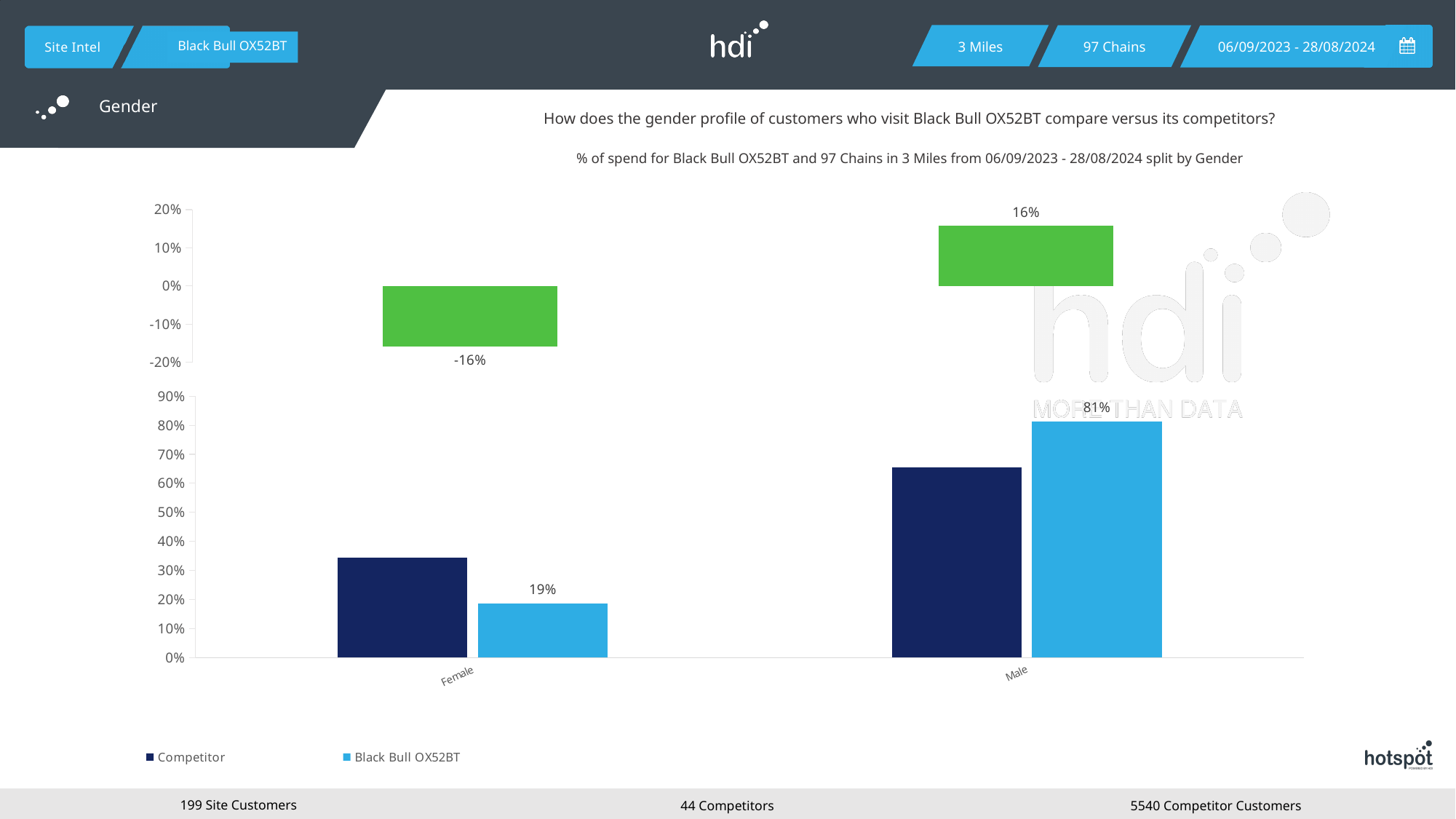
In the top chart, what is the value shown for Male? 16% In the bottom chart, is the Competitor value for Female greater or less than 30%? greater In the bottom chart, what is the difference between the Black Bull OX52BT values for Male and Female? 62% What type of chart is the bottom chart? Bar chart How many series does the legend of the bottom chart list? 2 In the bottom chart, is the Competitor value for Male greater or less than 70%? less In the bottom chart, what is the value for Black Bull OX52BT for Female? 19% In the bottom chart, which gender has the higher value for Black Bull OX52BT? Male In the top chart, what is the value shown for Female? -16% In the bottom chart, for Male, which is larger: the Competitor value or the Black Bull OX52BT value? Black Bull OX52BT In the bottom chart, what is the value for Black Bull OX52BT for Male? 81% In the bottom chart, for Female, which is larger: the Competitor value or the Black Bull OX52BT value? Competitor